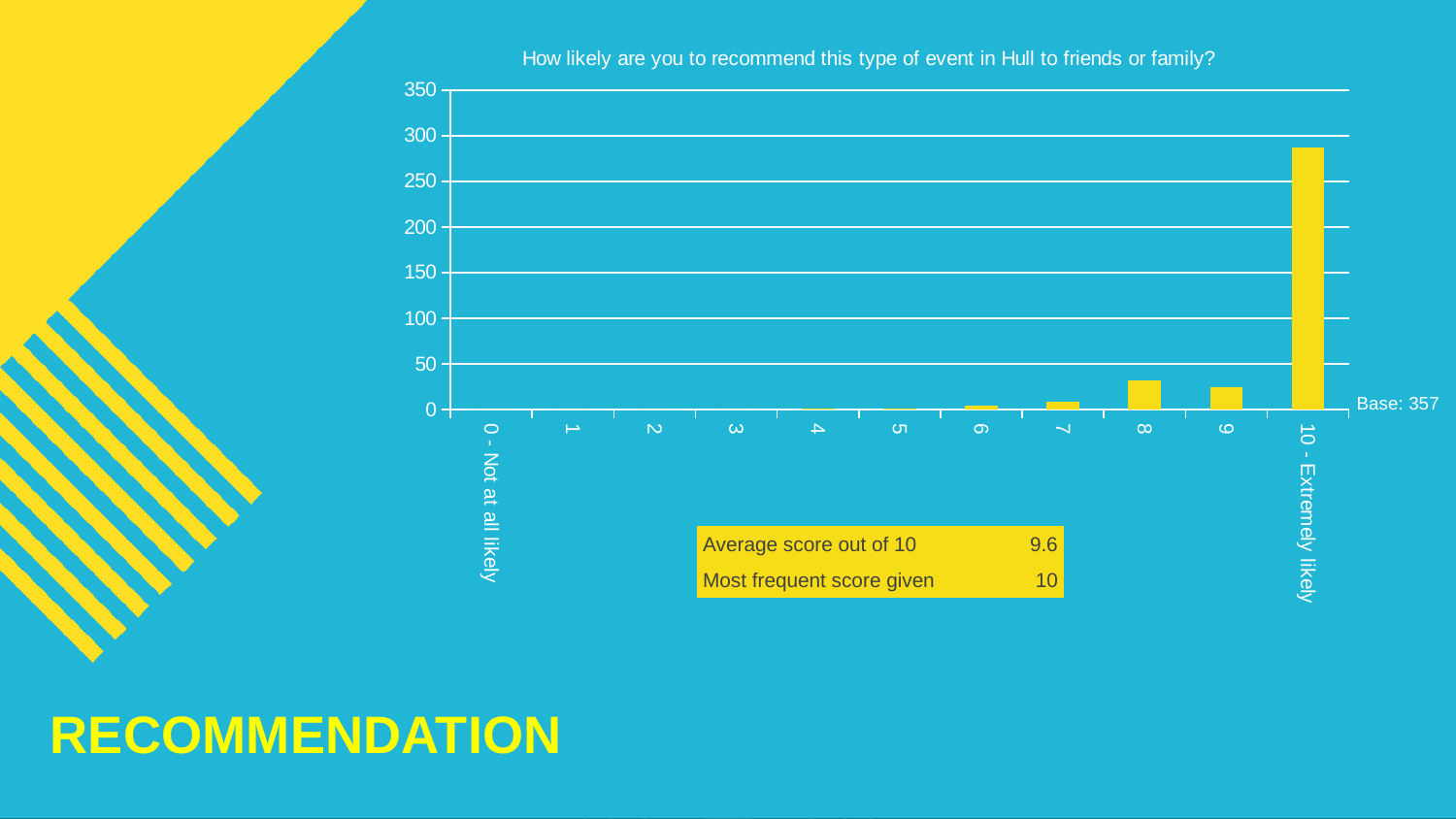
What kind of chart is shown on the slide? bar chart Is the value for the score of 10 greater or less than 250? greater Is the value for the score of 8 greater or less than 50? less What is the base (number of respondents) shown for the chart? 357 Which has more responses, a score of 8 or a score of 9? 8 Do the values generally rise or fall as the score increases from 5 to 10 along the x axis? rise Which score category has the highest number of responses? 10 - Extremely likely Is the value for the score of 9 greater or less than 50? less How many score categories are shown on the x axis? 11 What is the title of the chart? How likely are you to recommend this type of event in Hull to friends or family? Which has more responses, a score of 6 or a score of 7? 7